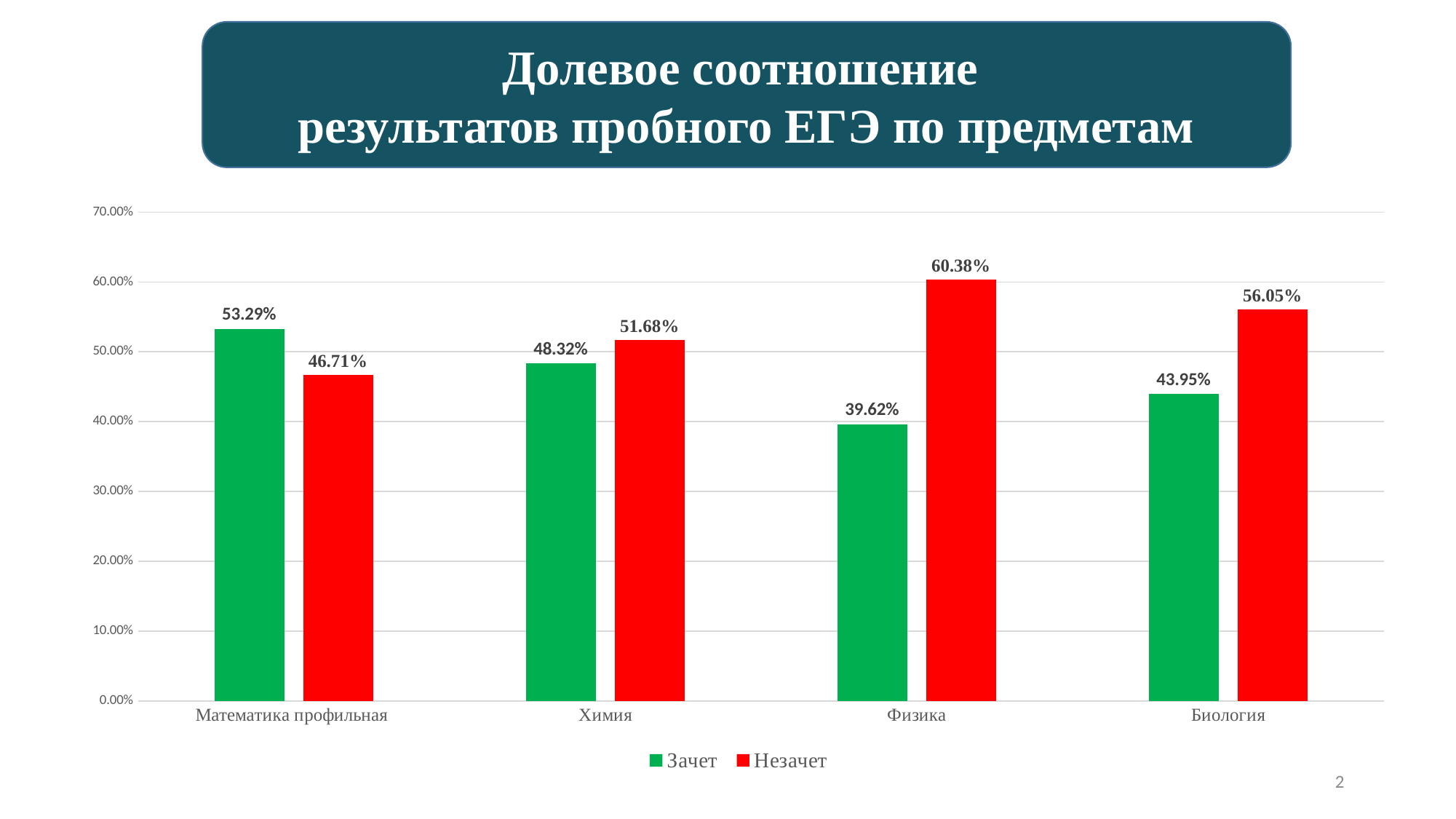
What is the Зачет value for Физика? 39.62% How many series does the legend list? 2 Is the Незачет value for Физика greater or less than 60.00%? greater What is the Незачет value for Биология? 56.05% What is the difference between the Незачет and Зачет values for Химия? 3.36% What colour are the Незачет bars? Red Which subject has the highest Незачет value? Физика What is the Зачет value for Математика профильная? 53.29% What kind of chart is shown on the slide? Bar chart Which subject has the lowest Зачет value? Физика How many subjects are shown on the x axis? 4 Which is larger for Математика профильная, Зачет or Незачет? Зачет